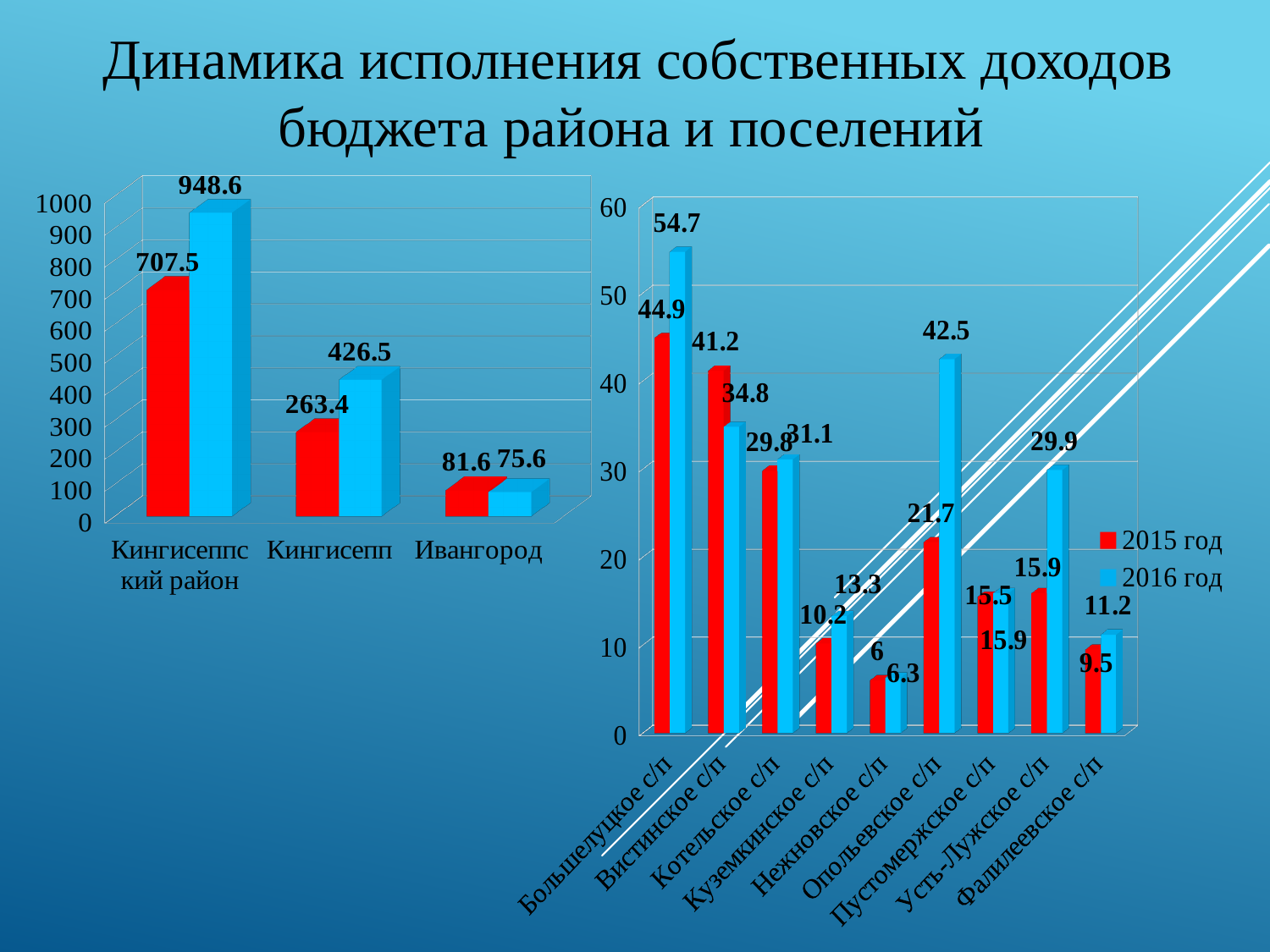
In the right chart, how many series does the legend list? 2 In the right chart, what is the 2015 value for Вистинское с/п? 41.2 In the right chart, which is larger for Вистинское с/п: the 2015 value or the 2016 value? 2015 value What type of chart is the right chart? Bar chart In the left chart, which category has the lowest 2016 value? Ивангород In the left chart, what is the 2015 value for Кингисепп? 263.4 In the left chart, what is the difference between the 2016 and 2015 values for Кингисепп? 163.1 In the left chart, how many categories are shown on the x axis? 3 In the right chart, what is the 2016 value for Опольевское с/п? 42.5 In the right chart, which category has the lowest 2015 value? Нежновское с/п In the right chart, which category has the highest 2016 value? Большелуцкое с/п In the left chart, what is the 2016 value for Кингисеппский район? 948.6